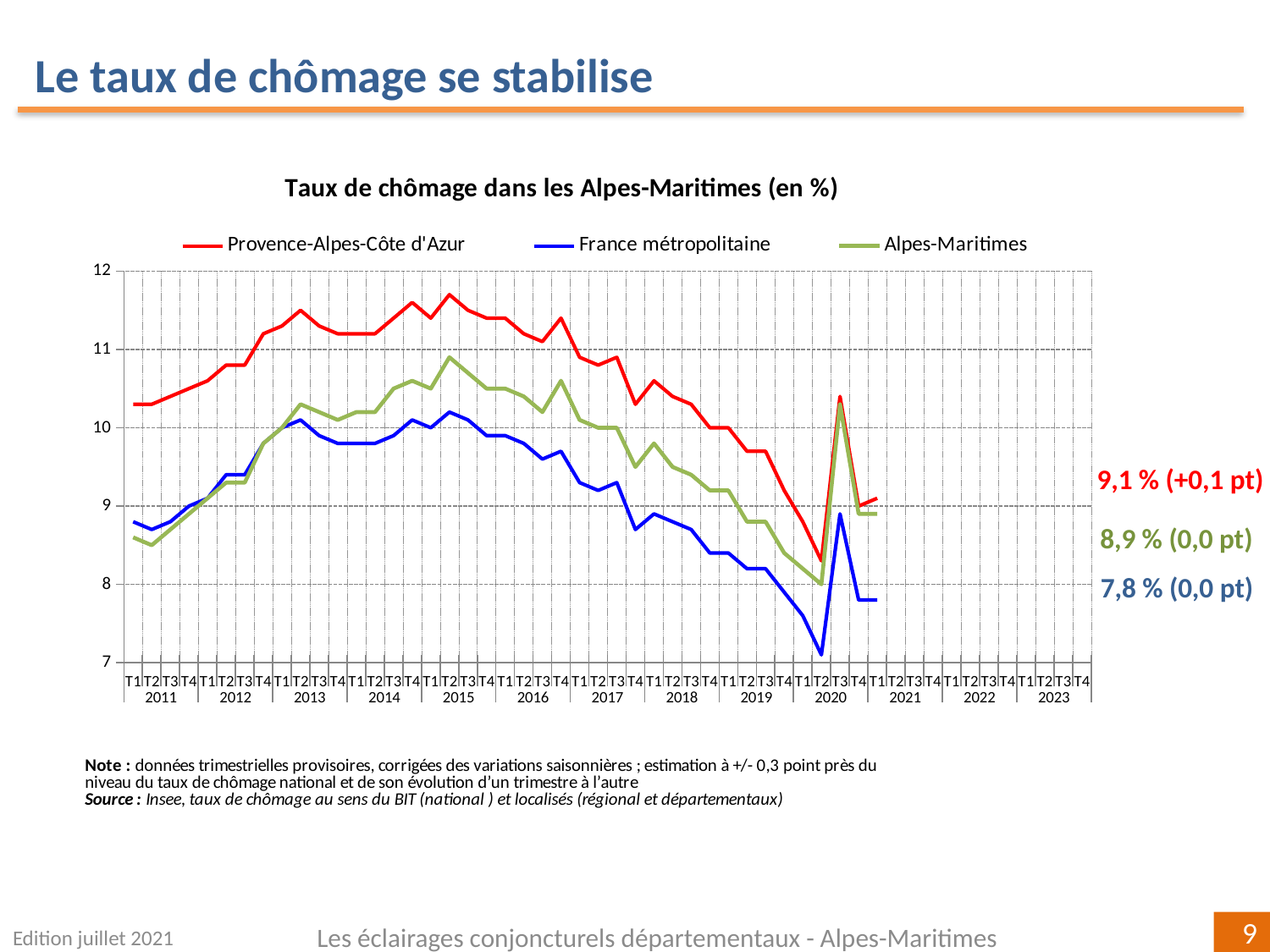
What is the difference between the latest Provence-Alpes-Côte d'Azur rate and the latest France métropolitaine rate? 1,3 points Is the value for France métropolitaine at T2 2020 greater or less than 8? less How many series does the legend list? 3 What is the latest unemployment rate shown for France métropolitaine? 7,8 % At the latest point, which series has the highest unemployment rate? Provence-Alpes-Côte d'Azur What is the latest unemployment rate shown for Provence-Alpes-Côte d'Azur? 9,1 % What is the quarterly change shown for the latest Provence-Alpes-Côte d'Azur value? +0,1 pt What is the latest unemployment rate shown for Alpes-Maritimes? 8,9 % Is the value for Provence-Alpes-Côte d'Azur at T2 2015 greater or less than 11? greater Between 2015 and 2019, does the Provence-Alpes-Côte d'Azur line rise or fall overall? fall What is the title of the chart? Taux de chômage dans les Alpes-Maritimes (en %) What kind of chart is shown on the slide? line chart